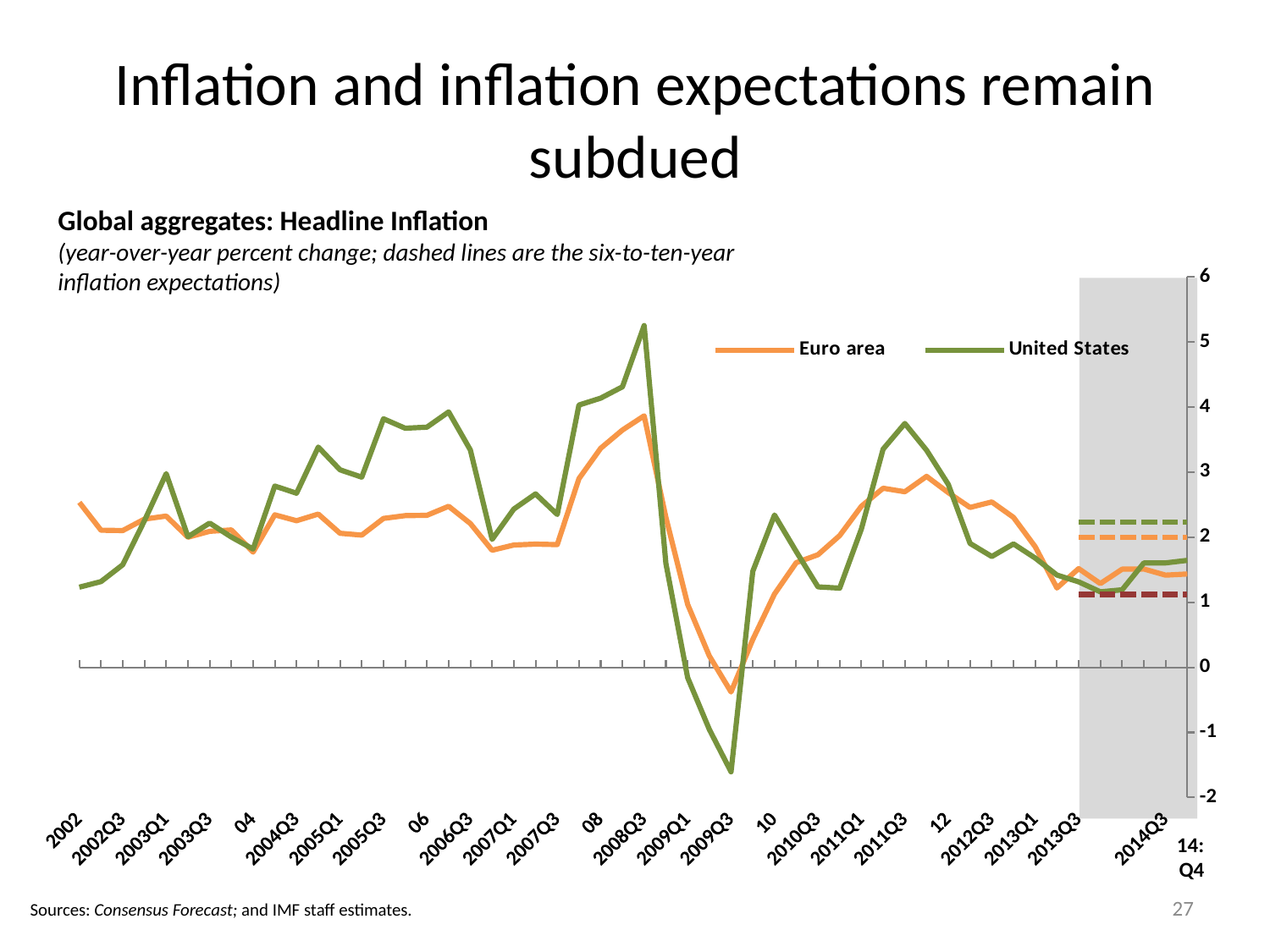
Which series reaches the highest value on the chart? United States Is the peak value of the United States series around 2008Q3 greater or less than 4? greater Which series reaches the lowest value on the chart? United States How many series does the legend list? 2 What is the title of the chart? Global aggregates: Headline Inflation Is the peak value of the Euro area series around 2008Q3 greater or less than 3? greater Is the lowest value of the Euro area series around 2009Q3 greater or less than 0? less Which two series are listed in the chart legend? Euro area and United States What kind of chart is shown on the slide? line chart At 2011Q3, which series has the higher value, Euro area or United States? United States Between 2008Q3 and 2009Q3, do the values of the United States series rise or fall? fall